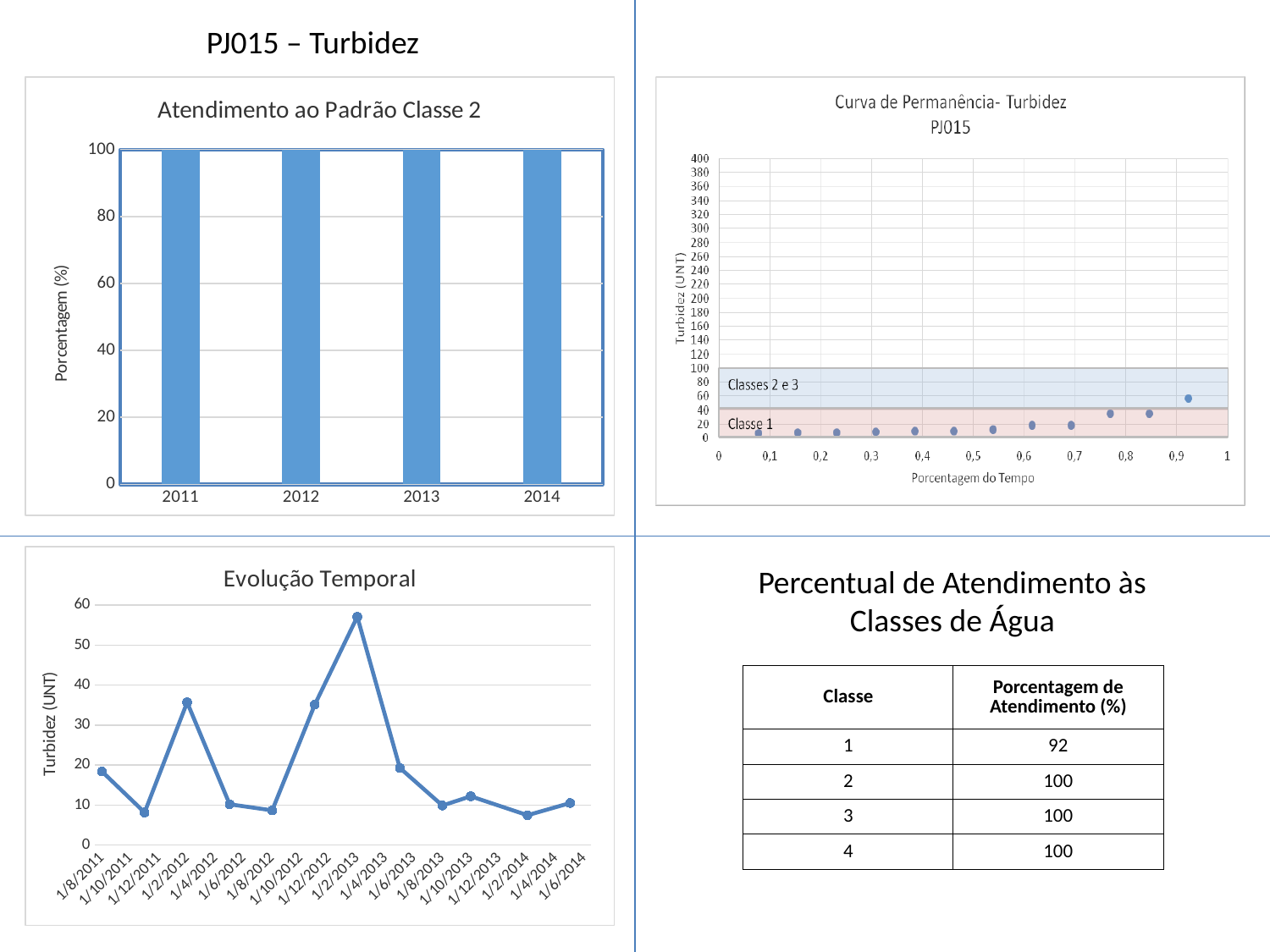
In the 'Curva de Permanência - Turbidez PJ015' chart, is the highest plotted point greater or less than 100? less What kind of chart is 'Evolução Temporal'? line chart What is the y-axis title of the 'Evolução Temporal' chart? Turbidez (UNT) In the 'Evolução Temporal' chart, is the value for 1/2/2013 greater or less than 50? greater In the 'Evolução Temporal' chart, which is larger, the value for 1/2/2013 or the value for 1/2/2012? 1/2/2013 What kind of chart is 'Atendimento ao Padrão Classe 2'? bar chart In the 'Evolução Temporal' chart, do the values rise or fall from 1/2/2013 to 1/4/2013? fall In the 'Evolução Temporal' chart, is the value for 1/10/2011 greater or less than 10? less In the 'Atendimento ao Padrão Classe 2' chart, what is the value for 2011? 100 In the 'Atendimento ao Padrão Classe 2' chart, what is the value for 2014? 100 In the 'Evolução Temporal' chart, which date has the highest turbidity value? 1/2/2013 In the 'Atendimento ao Padrão Classe 2' chart, how many years are shown on the x axis? 4